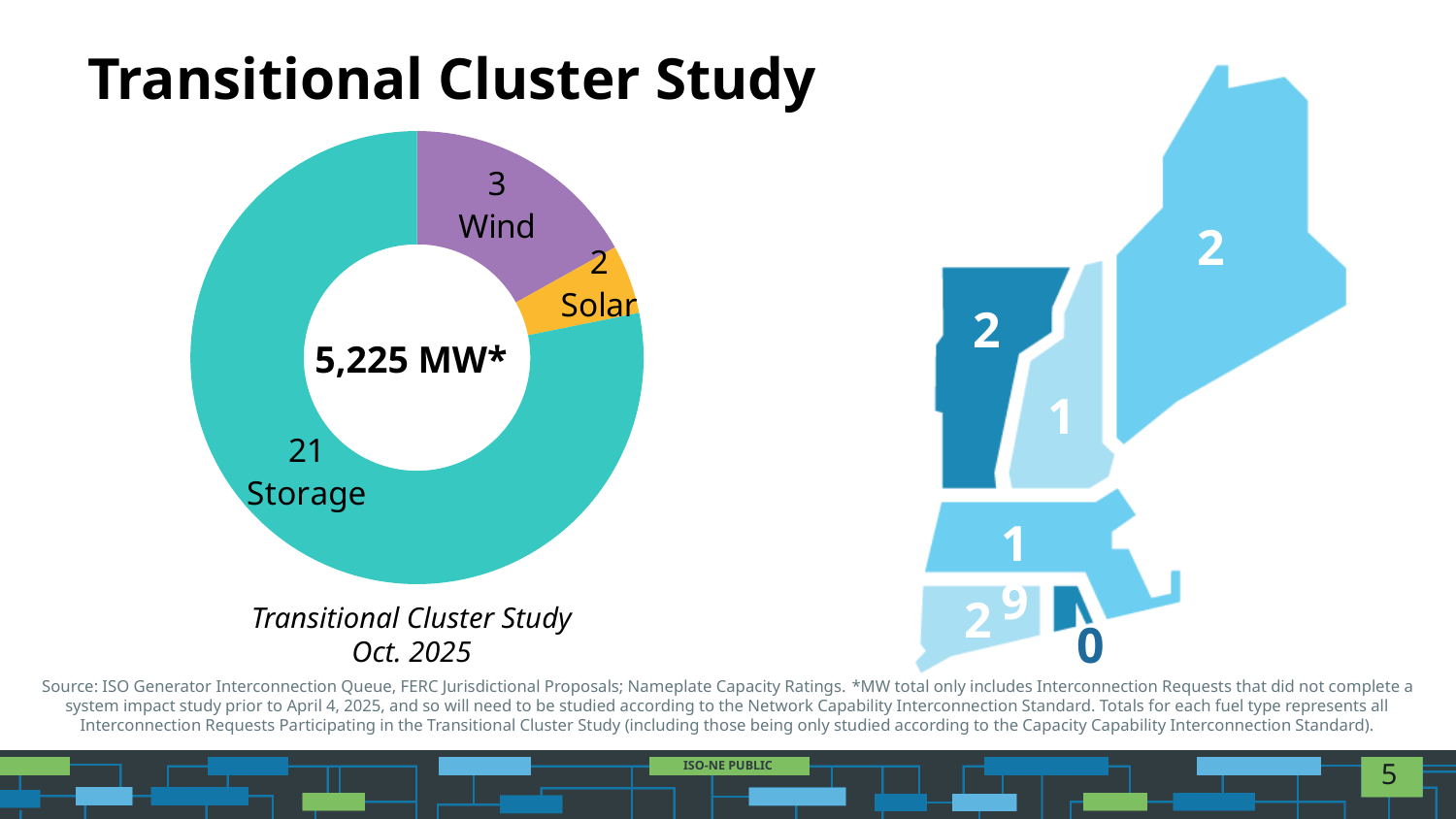
What is the sum of the three category values shown in the donut chart? 26 What is the value shown for Storage in the donut chart? 21 Which category has the smallest slice in the donut chart? Solar What text is printed in the center of the donut chart? 5,225 MW* How many categories are shown in the donut chart? 3 What is the difference between the Storage value and the Wind value in the donut chart? 18 What is the difference between the Wind value and the Solar value in the donut chart? 1 Which is larger in the donut chart, Wind or Solar? Wind What is the value shown for Solar in the donut chart? 2 What kind of chart is used to show the Storage, Wind and Solar values? Pie chart (donut) What is the value shown for Wind in the donut chart? 3 Which category has the largest slice in the donut chart? Storage